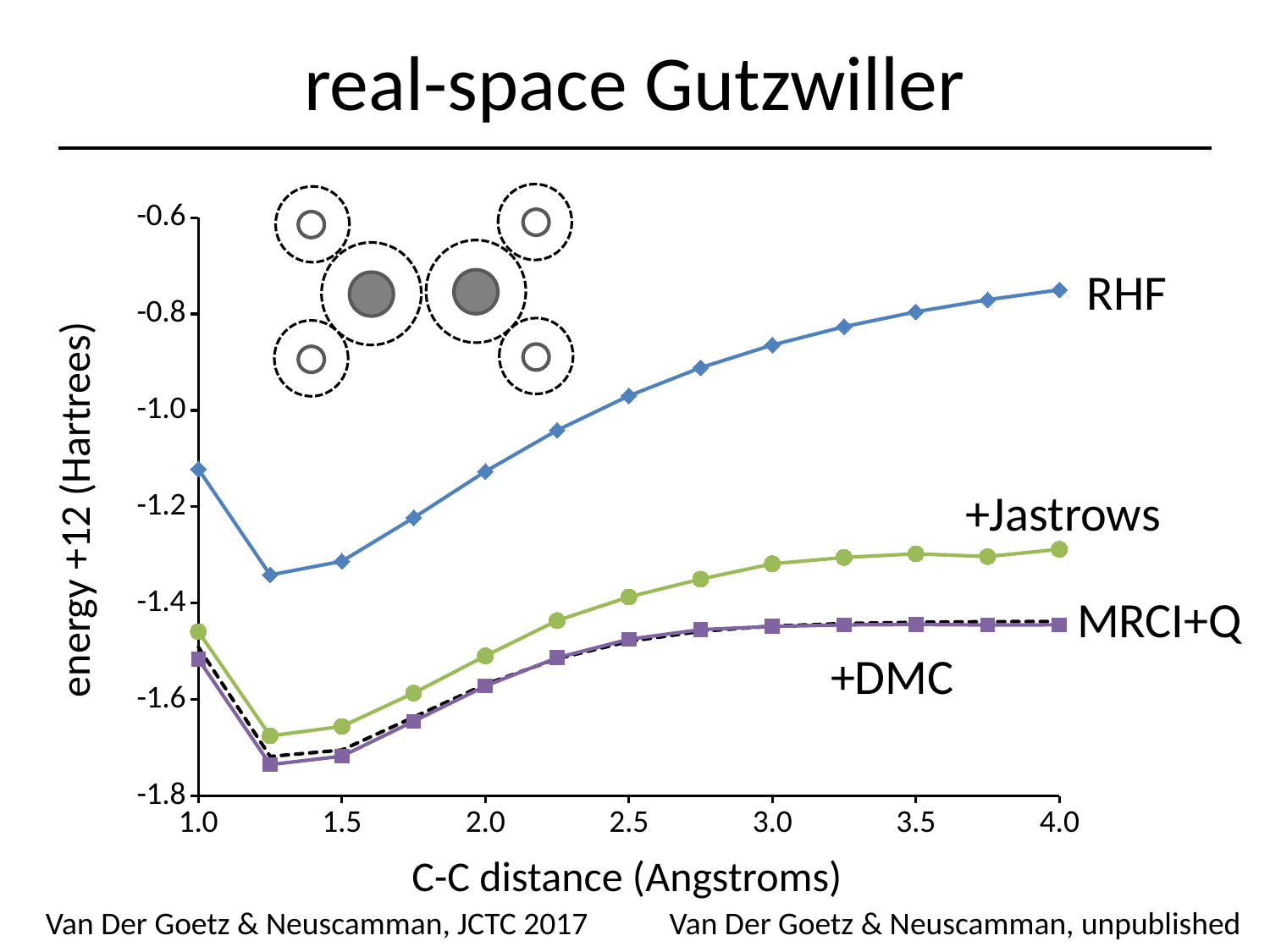
At a C-C distance of 1.5, which is higher: +Jastrows or +DMC? +Jastrows How many data points does the RHF series have? 13 How many data series are labelled on the chart? 4 At a C-C distance of 2.0, which is higher: RHF or +Jastrows? RHF Does the RHF series rise or fall as the C-C distance increases from 1.25 to 4.0? rise Is the +DMC value at a C-C distance of 1.25 greater or less than -1.6? less Which series has the highest energy at a C-C distance of 4.0? RHF What kind of chart is shown on the slide? line chart What is the label of the x axis? C-C distance (Angstroms) Is the RHF value at a C-C distance of 1.25 greater or less than -1.2? less Is the RHF value at a C-C distance of 4.0 greater or less than -0.8? greater